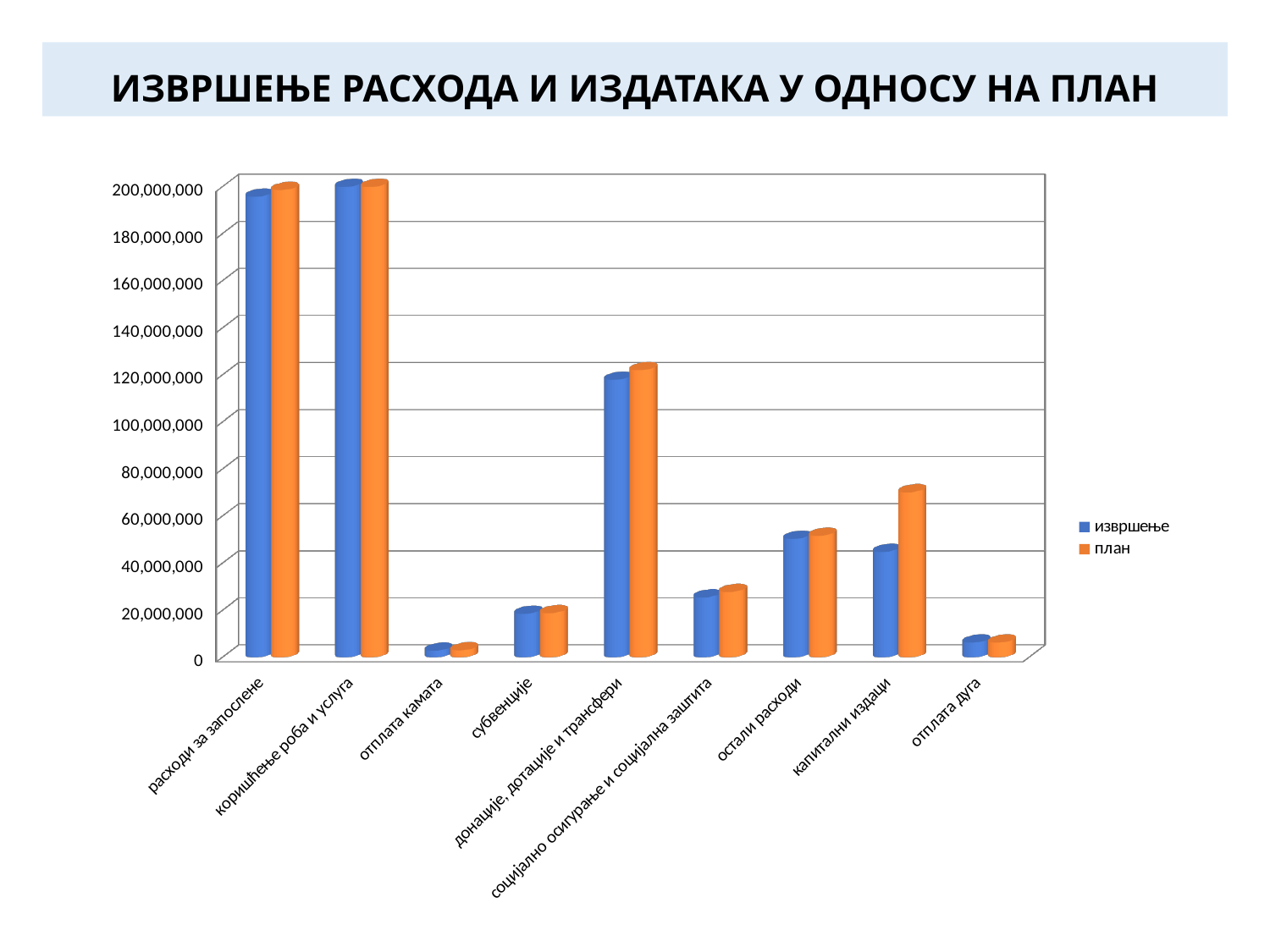
Is the извршење value for остали расходи greater or less than 40,000,000? greater For капитални издаци, which is larger: извршење or план? план Is the план value for капитални издаци greater or less than 60,000,000? greater Which category has the lowest value for план? отплата камата Which series is shown in orange in the legend? план Is the план value for отплата дуга greater or less than 20,000,000? less How many series does the legend list? 2 What kind of chart is shown on the slide? bar chart How many categories are shown on the x axis? 9 Which category has the lowest value for извршење? отплата камата